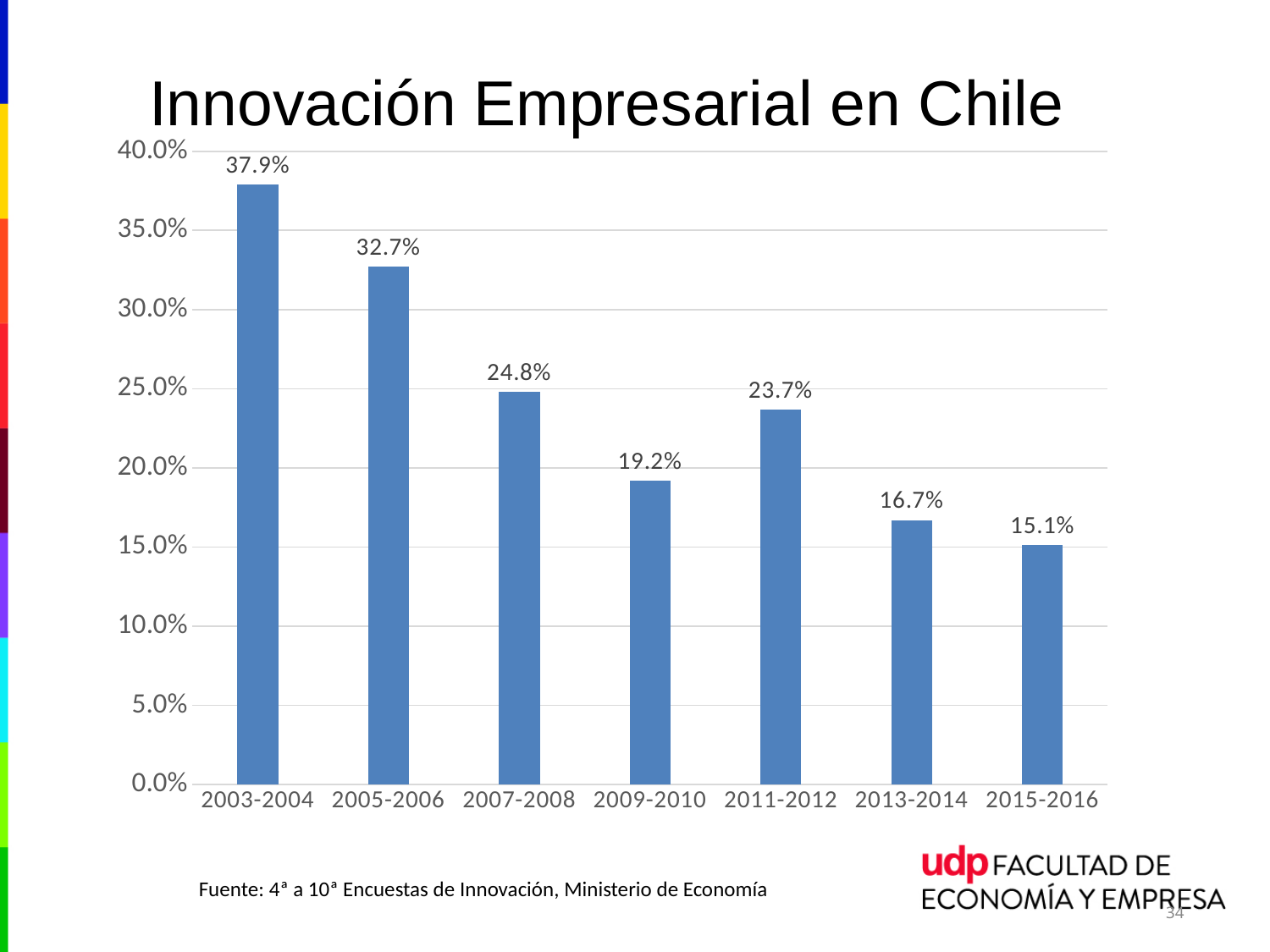
What is the value for 2003-2004? 37.9% What is the title of the chart? Innovación Empresarial en Chile How many periods are shown on the x axis? 7 What is the value for 2015-2016? 15.1% What kind of chart is shown on the slide? bar chart Is the value for 2013-2014 greater or less than 20.0%? less Which is larger, the value for 2007-2008 or the value for 2011-2012? 2007-2008 Which period has the highest value? 2003-2004 Which period has the lowest value? 2015-2016 What is the difference between the values for 2003-2004 and 2005-2006? 5.2% What is the difference between the values for 2009-2010 and 2011-2012? 4.5% What is the value for 2011-2012? 23.7%